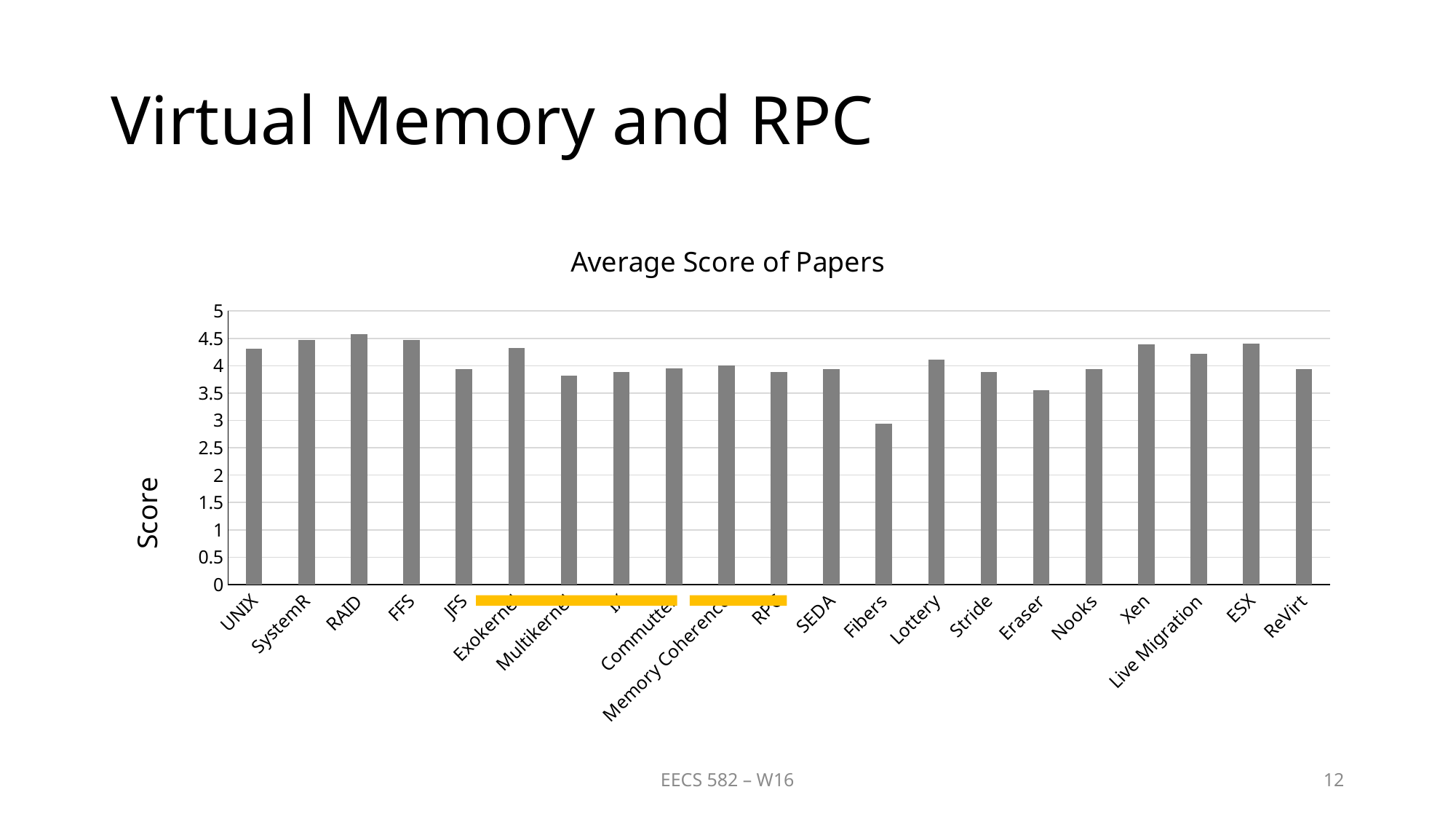
Is the value for UNIX greater or less than 4? greater Which has the higher average score, Xen or Eraser? Xen What kind of chart is shown on the slide? bar chart Is the value for Multikernel greater or less than 4? less What is the label on the vertical axis of the chart? Score Which has the higher average score, RAID or JFS? RAID Is the value for Fibers greater or less than 3? less Which paper has the lowest average score? Fibers What is the title of the chart? Average Score of Papers Which has the higher average score, Fibers or Nooks? Nooks